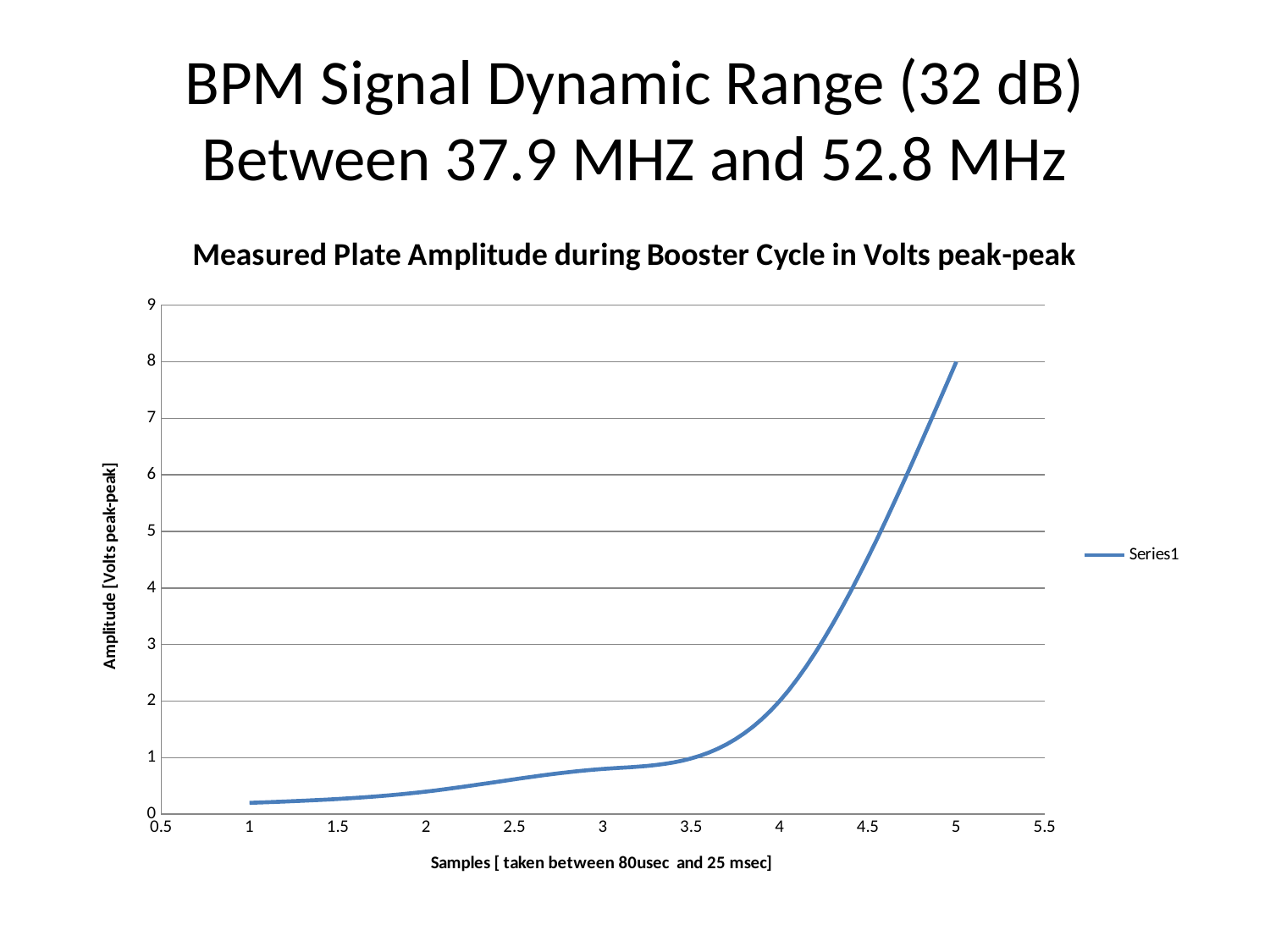
What kind of chart is shown on the slide? line chart What is the title of the chart? Measured Plate Amplitude during Booster Cycle in Volts peak-peak Is the amplitude at sample 4 greater or less than 1? greater How many series does the legend list? 1 At which sample number is the amplitude lowest? 1 At which sample number does the line reach its highest amplitude? 5 Is the amplitude at sample 3 greater or less than 1? less Is the amplitude at sample 5 greater or less than 7? greater What is the name of the series shown in the legend? Series1 Which has the larger amplitude, sample 2 or sample 4? sample 4 Do the plotted values rise or fall as the sample number increases along the x axis? rise